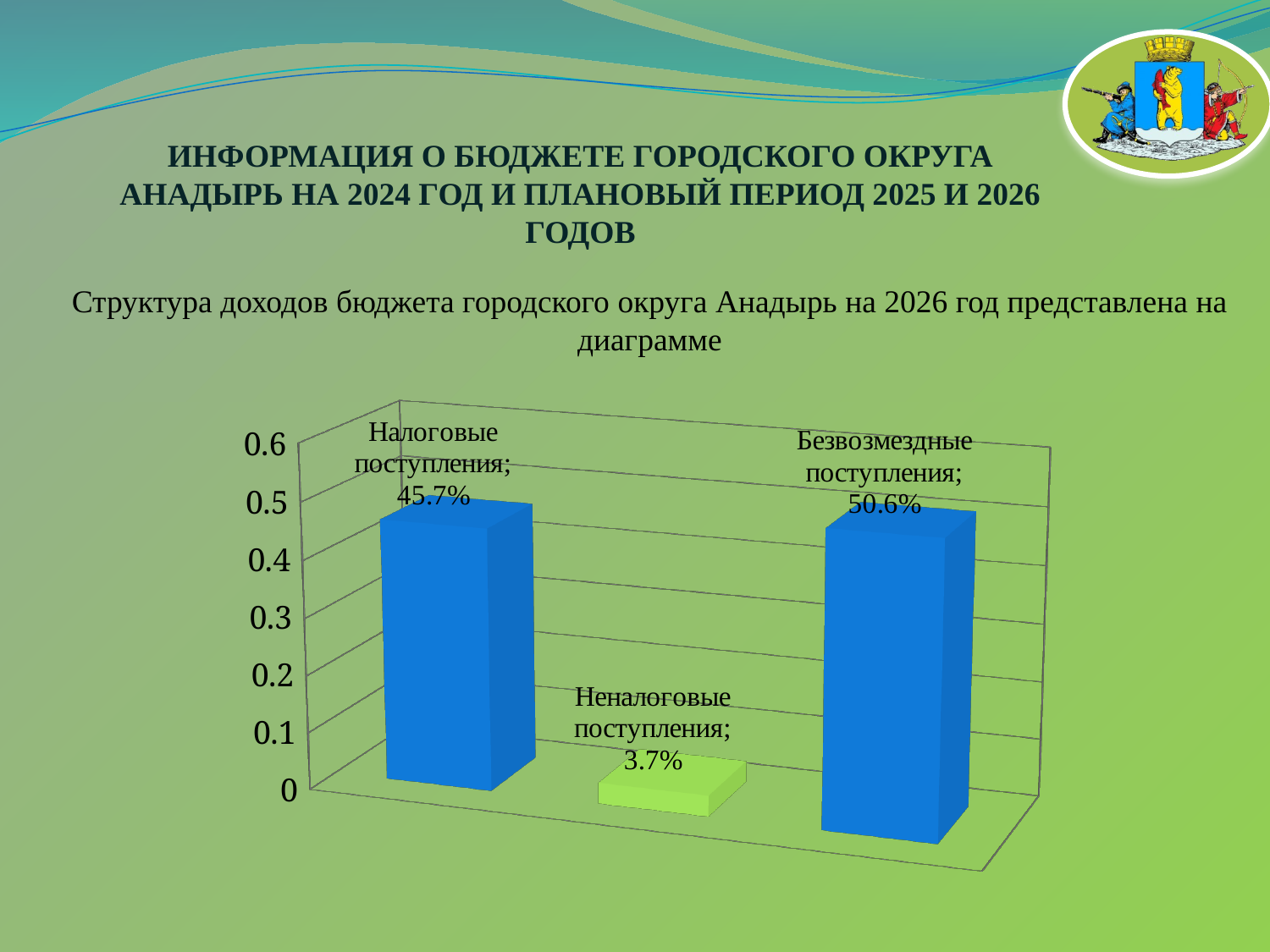
What is the difference between Безвозмездные поступления and Налоговые поступления? 4.9% Which is larger, Налоговые поступления or Безвозмездные поступления? Безвозмездные поступления What kind of chart is shown on the slide? Bar chart What is the value for Неналоговые поступления? 3.7% Is the value for Неналоговые поступления greater or less than 0.1? less What is the value for Налоговые поступления? 45.7% Is the value for Безвозмездные поступления greater or less than 0.5? greater What is the difference between Налоговые поступления and Неналоговые поступления? 42% Which category has the lowest value? Неналоговые поступления How many categories are shown in the chart? 3 What is the value for Безвозмездные поступления? 50.6% Which category has the highest value? Безвозмездные поступления